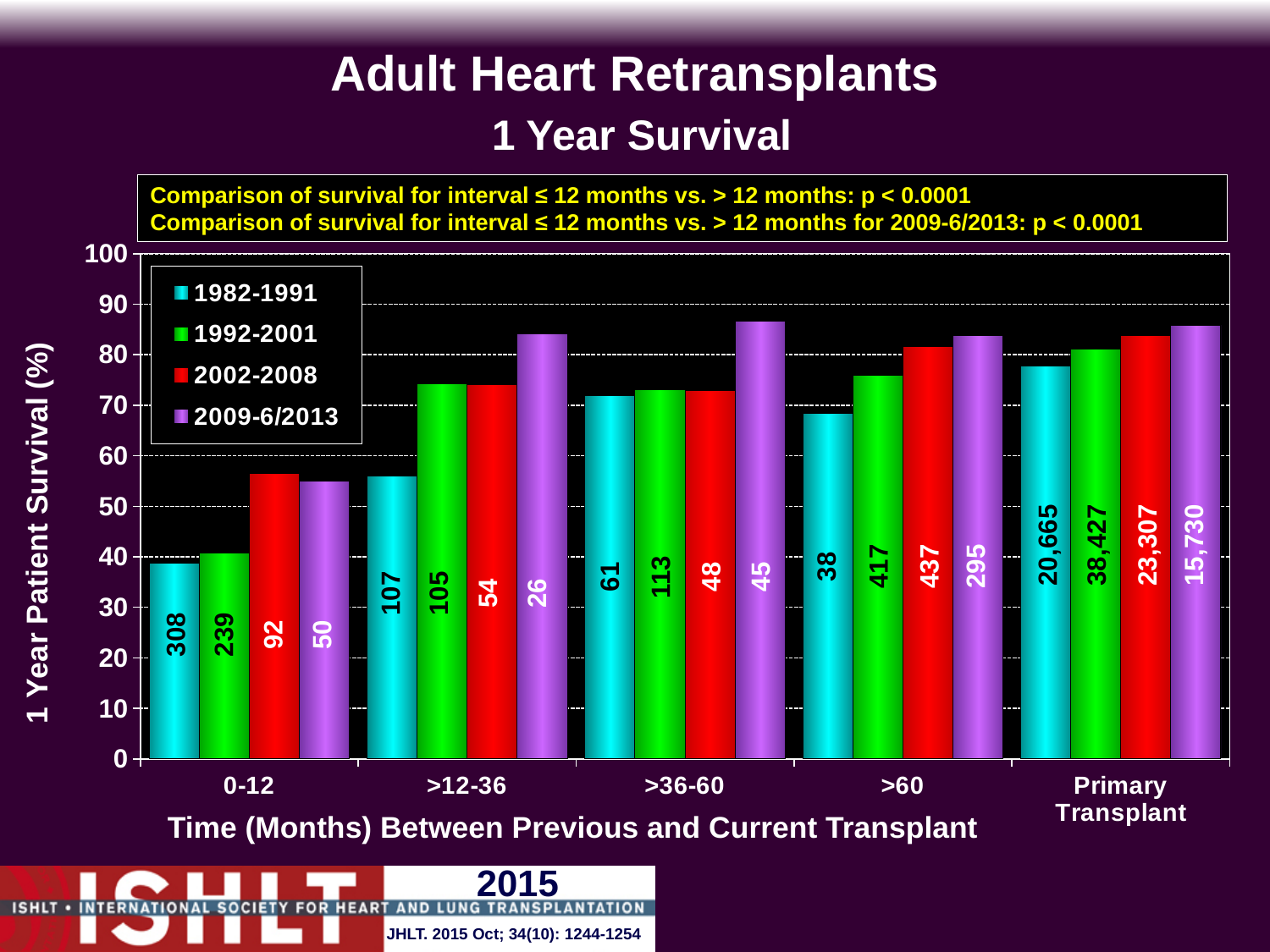
What number is printed on the 1992-2001 bar for Primary Transplant? 38,427 Which time interval category has the lowest 1 year survival for the 2009-6/2013 series? 0-12 What number is printed on the 1982-1991 bar for the 0-12 month category? 308 Is the 1 year survival for 2009-6/2013 in the >12-36 month category greater or less than 80? greater Is the 1 year survival for 2002-2008 in the 0-12 month category greater or less than 50? greater How many series does the legend list? 4 What kind of chart is shown on the slide? bar chart What is the title of the y axis? 1 Year Patient Survival (%) How many categories are shown along the x axis? 5 In the >60 month category, which has higher 1 year survival: 1982-1991 or 2009-6/2013? 2009-6/2013 What number is printed on the 2002-2008 bar for the >60 month category? 437 What number is printed on the 2009-6/2013 bar for the >12-36 month category? 26